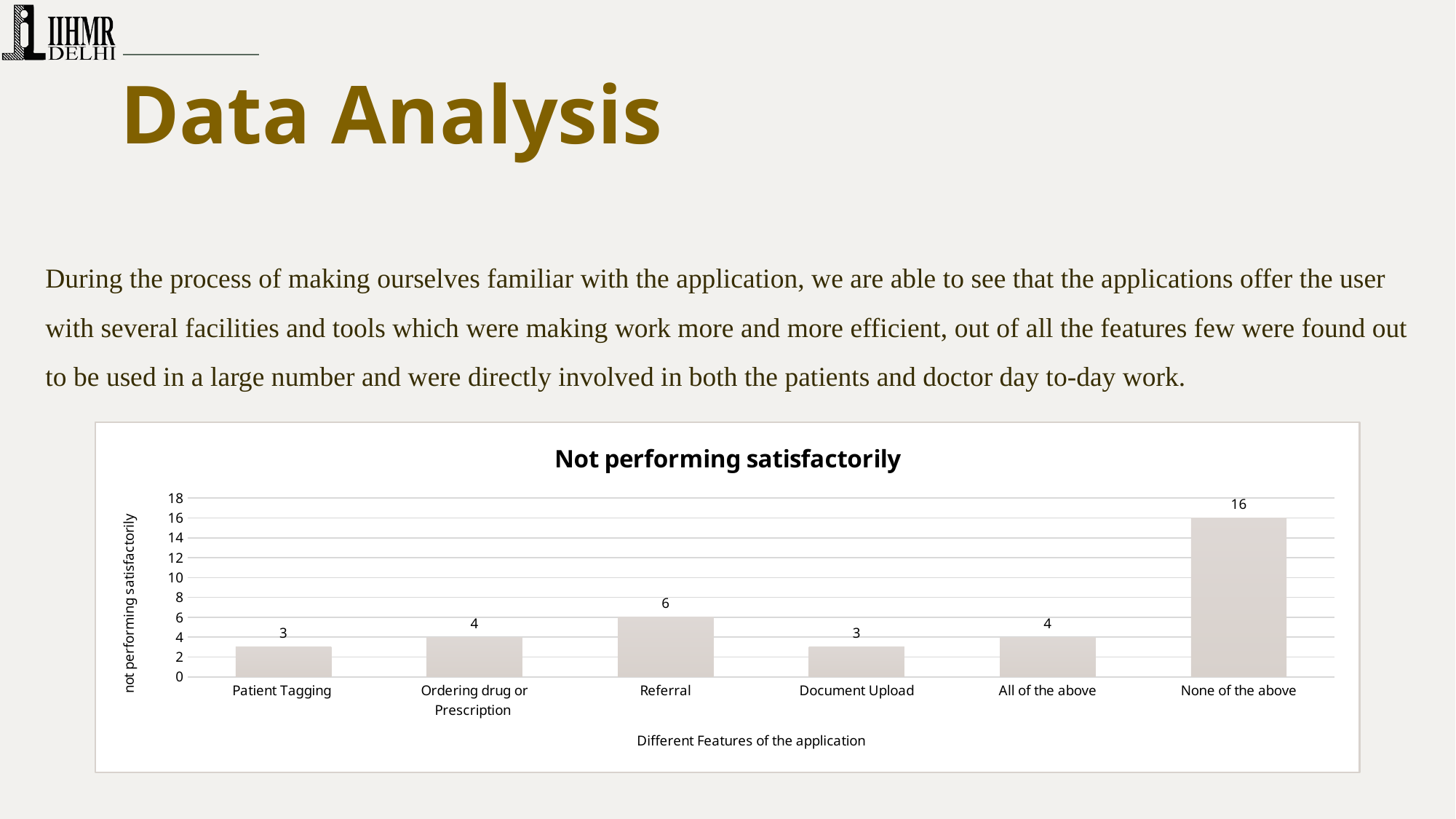
What is the difference between the values for Referral and Patient Tagging? 3 What is the value for Referral? 6 What is the x-axis title of the chart? Different Features of the application What is the difference between the values for None of the above and Referral? 10 What is the value for Ordering drug or Prescription? 4 How many categories are shown on the x axis? 6 What kind of chart is shown? bar chart Which category has the highest value? None of the above What is the value for None of the above? 16 Which is larger, the value for Referral or the value for Document Upload? Referral Is the value for None of the above greater or less than 10? greater What is the title of the chart? Not performing satisfactorily